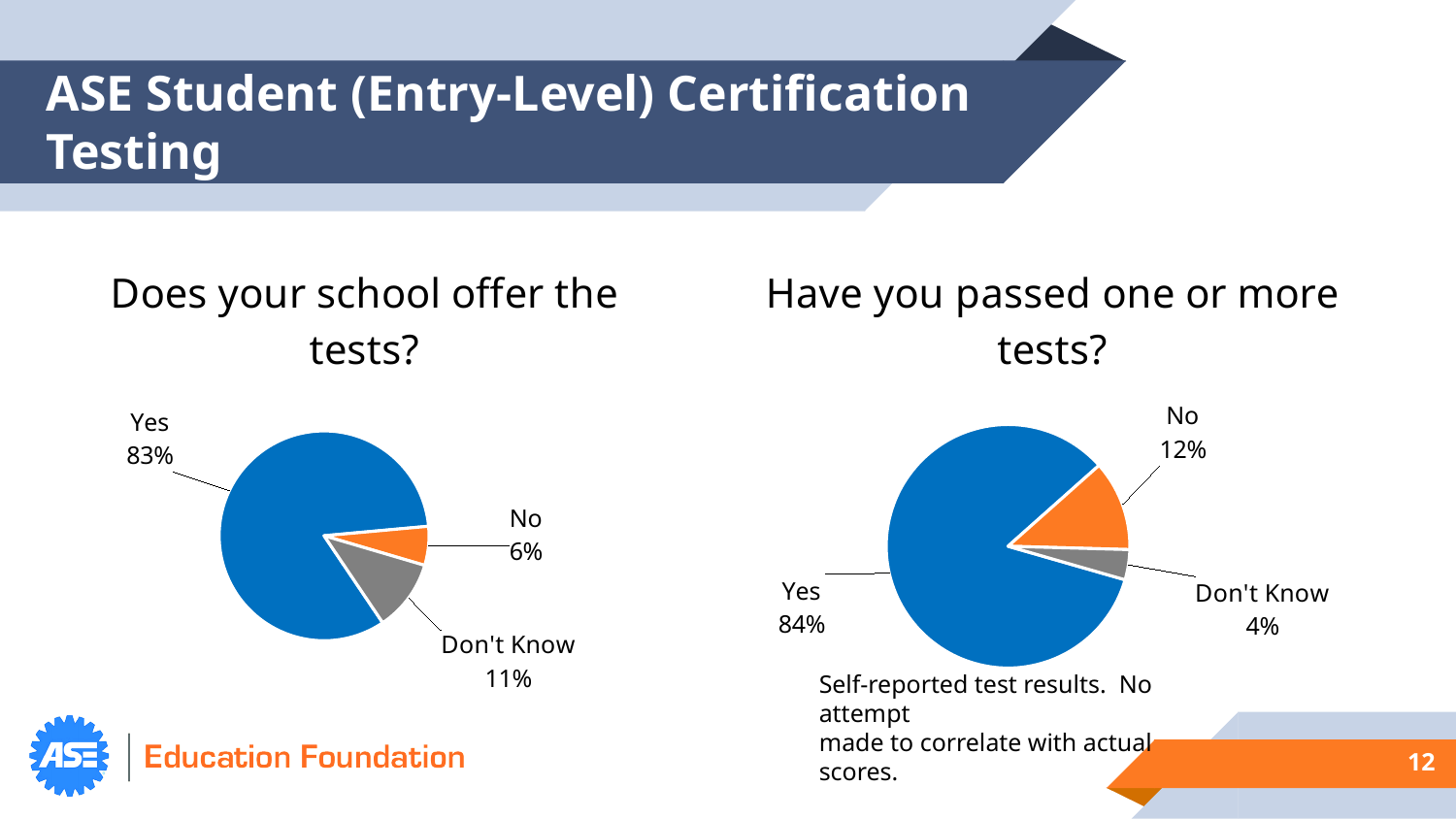
In the 'Have you passed one or more tests?' chart, which response has the largest share? Yes How many slices does the 'Have you passed one or more tests?' chart have? 3 In the 'Have you passed one or more tests?' chart, what is the difference between the No and Don't Know percentages? 8% In the 'Does your school offer the tests?' chart, what percentage answered Don't Know? 11% In the 'Does your school offer the tests?' chart, which is larger: No or Don't Know? Don't Know In the 'Have you passed one or more tests?' chart, what percentage answered Yes? 84% In the 'Have you passed one or more tests?' chart, what percentage answered No? 12% What type of chart is the 'Does your school offer the tests?' chart? Pie chart In the 'Does your school offer the tests?' chart, what is the difference between the Yes and Don't Know percentages? 72% In the 'Does your school offer the tests?' chart, what percentage answered Yes? 83% In the 'Does your school offer the tests?' chart, which response has the smallest share? No In the 'Have you passed one or more tests?' chart, what colour is the Yes slice? Blue